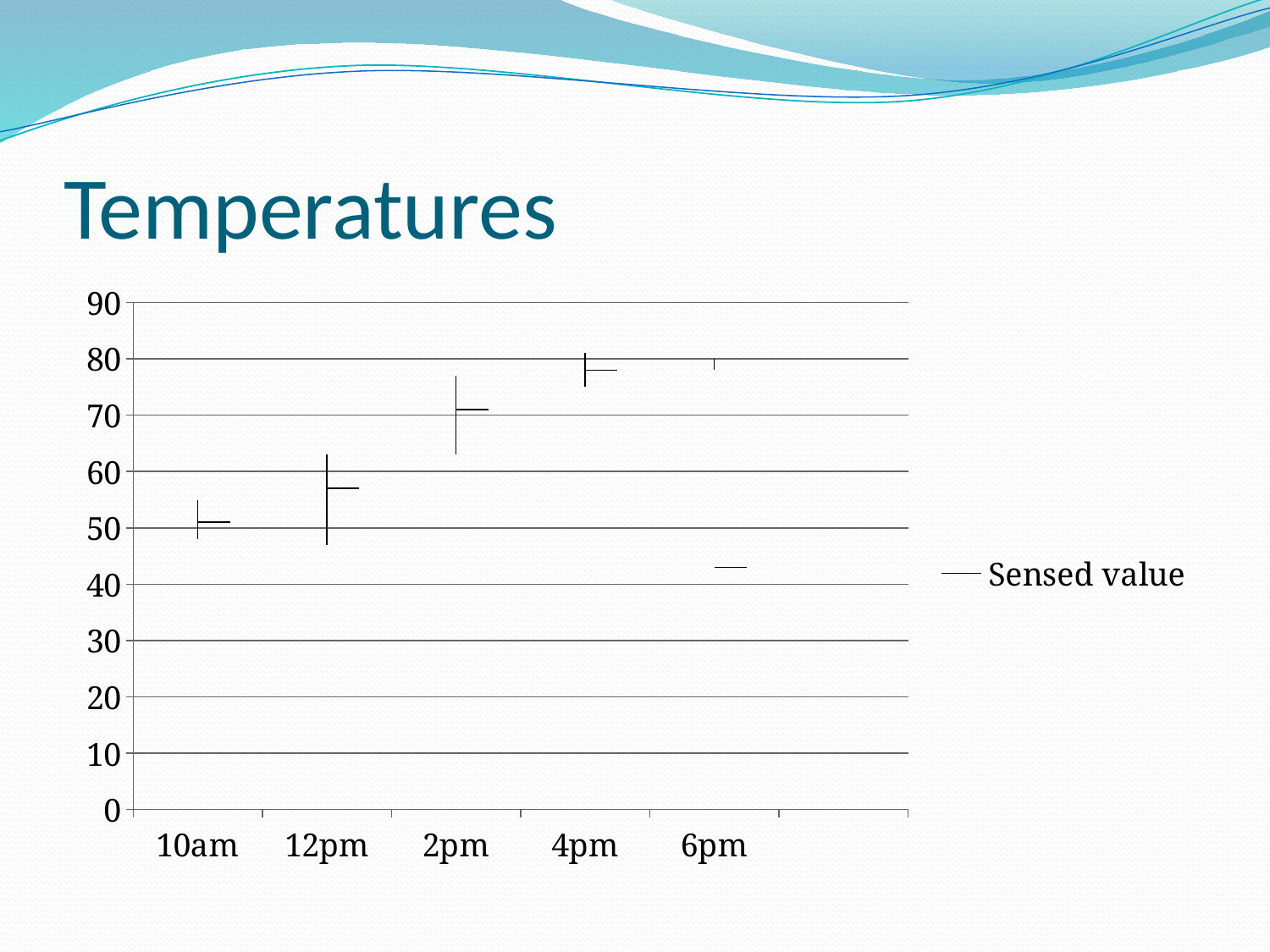
How many time categories are shown on the x axis of the chart? 5 At which time is the sensed value lowest? 6pm Is the sensed value at 10am greater or less than 60? less Is the sensed value at 2pm greater or less than 60? greater What is the title of the slide containing the chart? Temperatures Is the sensed value at 6pm greater or less than 40? greater Which has the larger sensed value, 12pm or 2pm? 2pm From 10am to 4pm, do the sensed values rise or fall? rise At which time is the sensed value highest? 4pm What is the name of the series shown in the legend? Sensed value How many series does the chart's legend list? 1